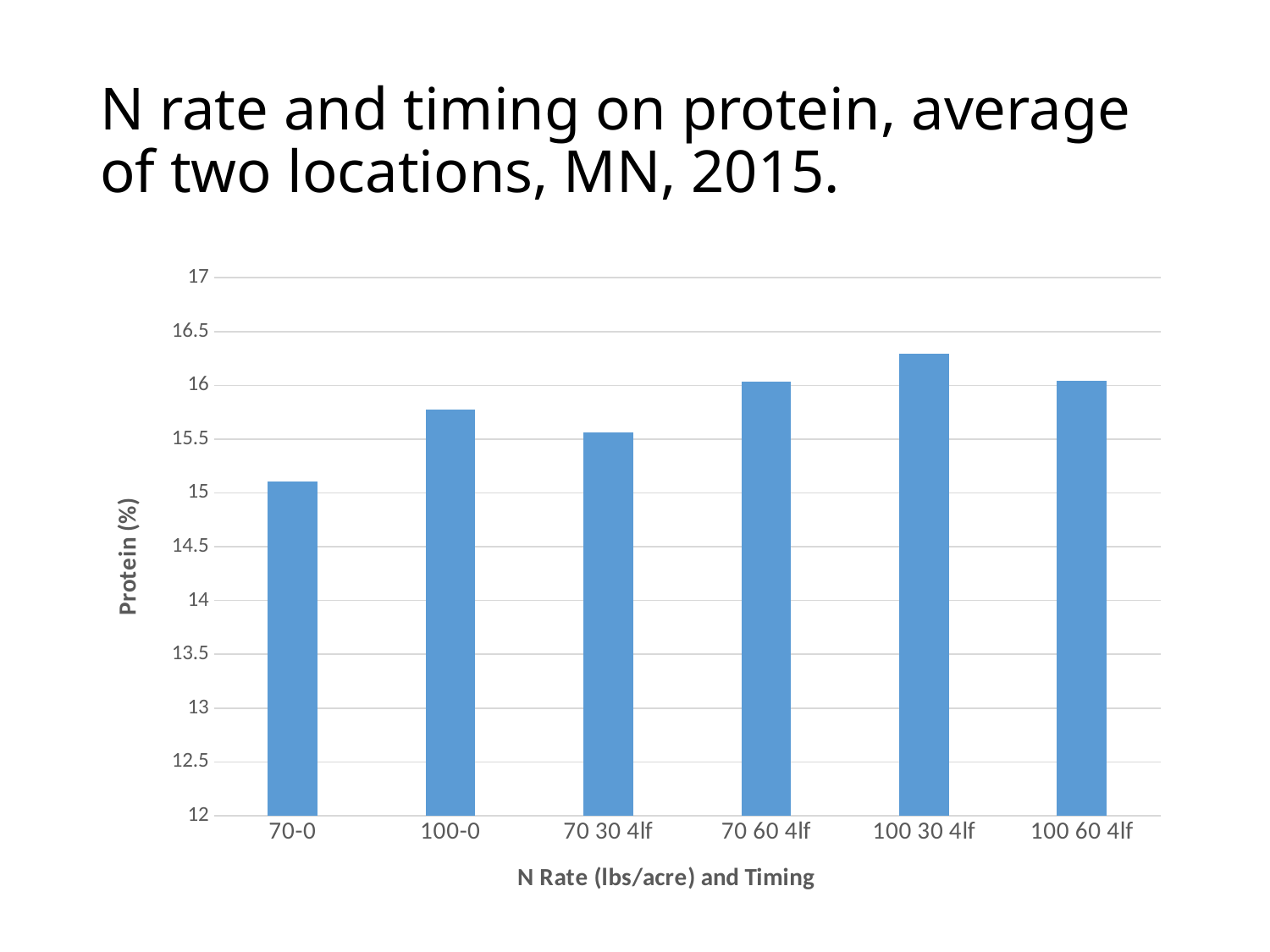
Which N rate and timing treatment has the lowest protein? 70-0 Which has the higher protein, 100-0 or 100 30 4lf? 100 30 4lf How many N rate and timing categories are plotted on the x axis? 6 What type of chart is shown on the slide? bar chart Is the protein value for 100 30 4lf greater or less than 16.5? less Which N rate and timing treatment has the highest protein? 100 30 4lf Is the protein value for 100-0 greater or less than 16? less Is the protein value for 100 30 4lf greater or less than 16? greater What is the label of the vertical axis? Protein (%) Which has the higher protein, 70-0 or 70 30 4lf? 70 30 4lf